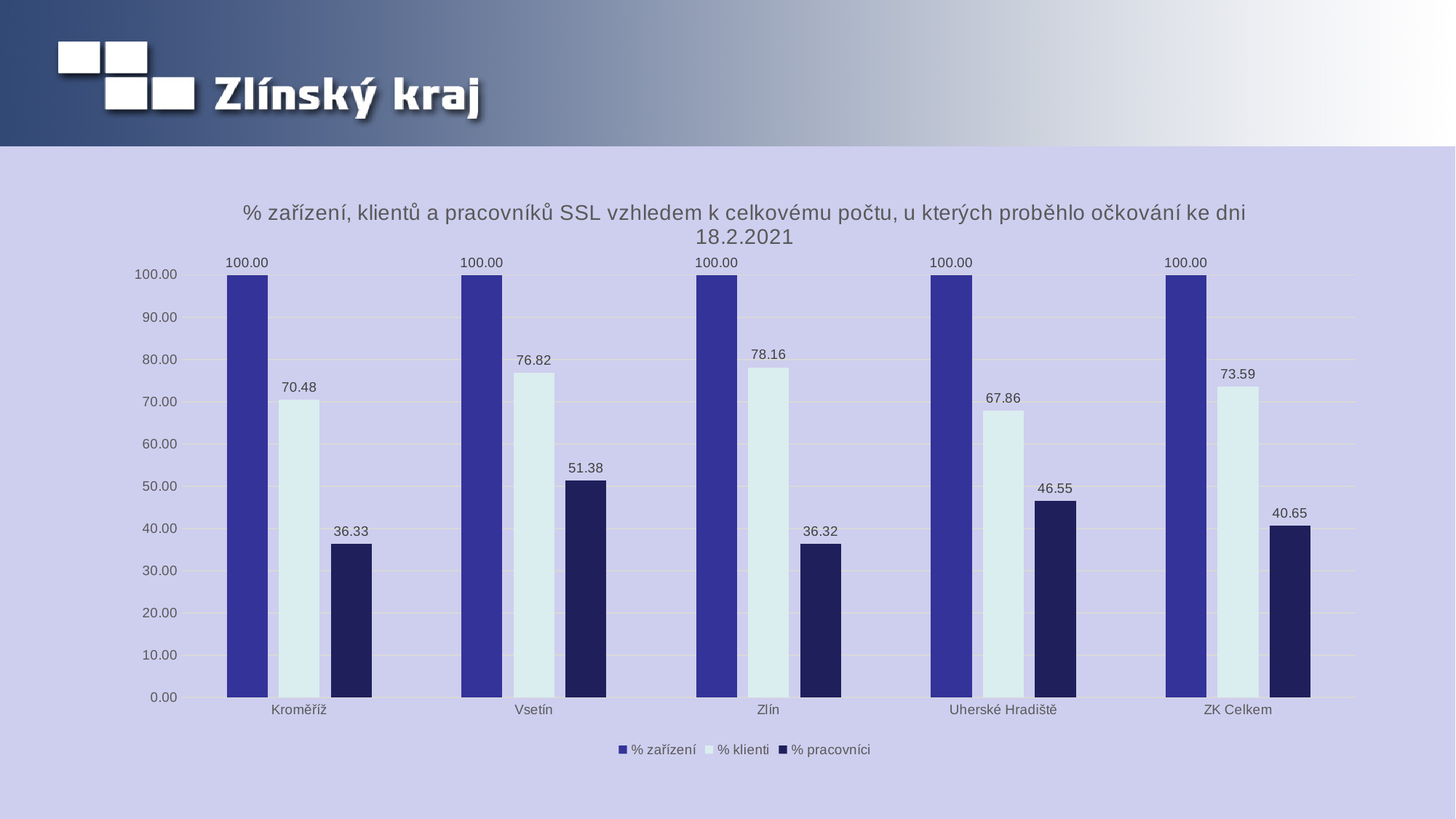
What is the difference between % klienti and % pracovníci for Kroměříž? 34.15 Which category has the lowest value for % pracovníci? Zlín What is the value of % pracovníci for Uherské Hradiště? 46.55 What is the value of % zařízení for Kroměříž? 100.00 Which category has the highest value for % klienti? Zlín How many categories are shown on the x axis? 5 What kind of chart is shown on the slide? Bar chart What is the value of % klienti for ZK Celkem? 73.59 How many series does the legend list? 3 What is the value of % klienti for Vsetín? 76.82 What is the date mentioned in the chart title? 18.2.2021 Which is larger: % pracovníci for Vsetín or % pracovníci for ZK Celkem? Vsetín